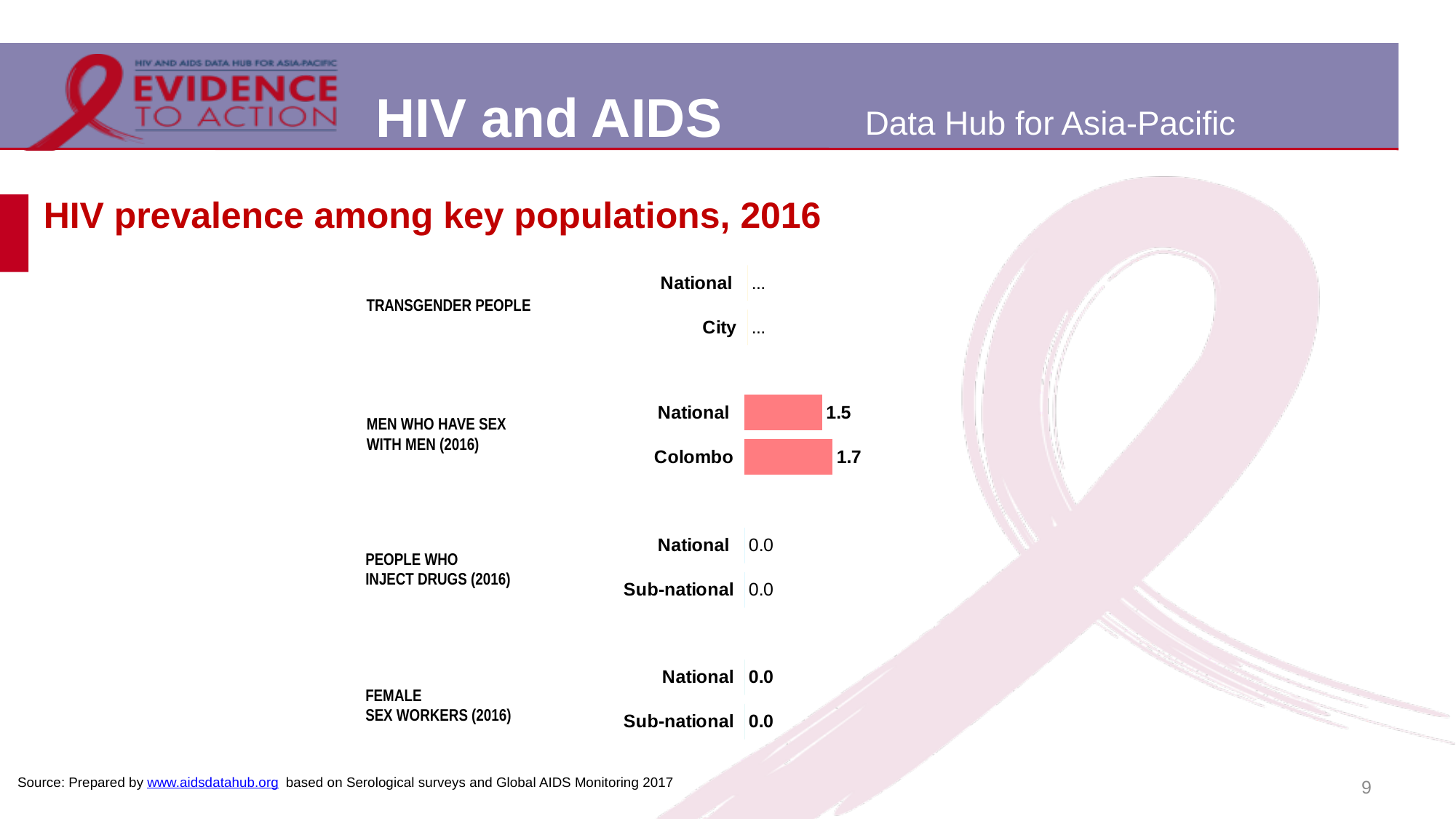
What is the sub-national HIV prevalence among female sex workers? 0.0 What value is shown for transgender people at the national level? ... What is the HIV prevalence among men who have sex with men at the national level? 1.5 What type of chart is used to show the HIV prevalence values? Bar chart What is the HIV prevalence among men who have sex with men in Colombo? 1.7 What is the title of the chart on the slide? HIV prevalence among key populations, 2016 For men who have sex with men, which is higher: the national value or the Colombo value? Colombo What is the difference between the Colombo and national HIV prevalence among men who have sex with men? 0.2 Which key population group shows the highest HIV prevalence value on the slide? Men who have sex with men What is the national HIV prevalence among people who inject drugs? 0.0 What colour are the bars for men who have sex with men? Pink How many key population groups are shown on the slide? 4